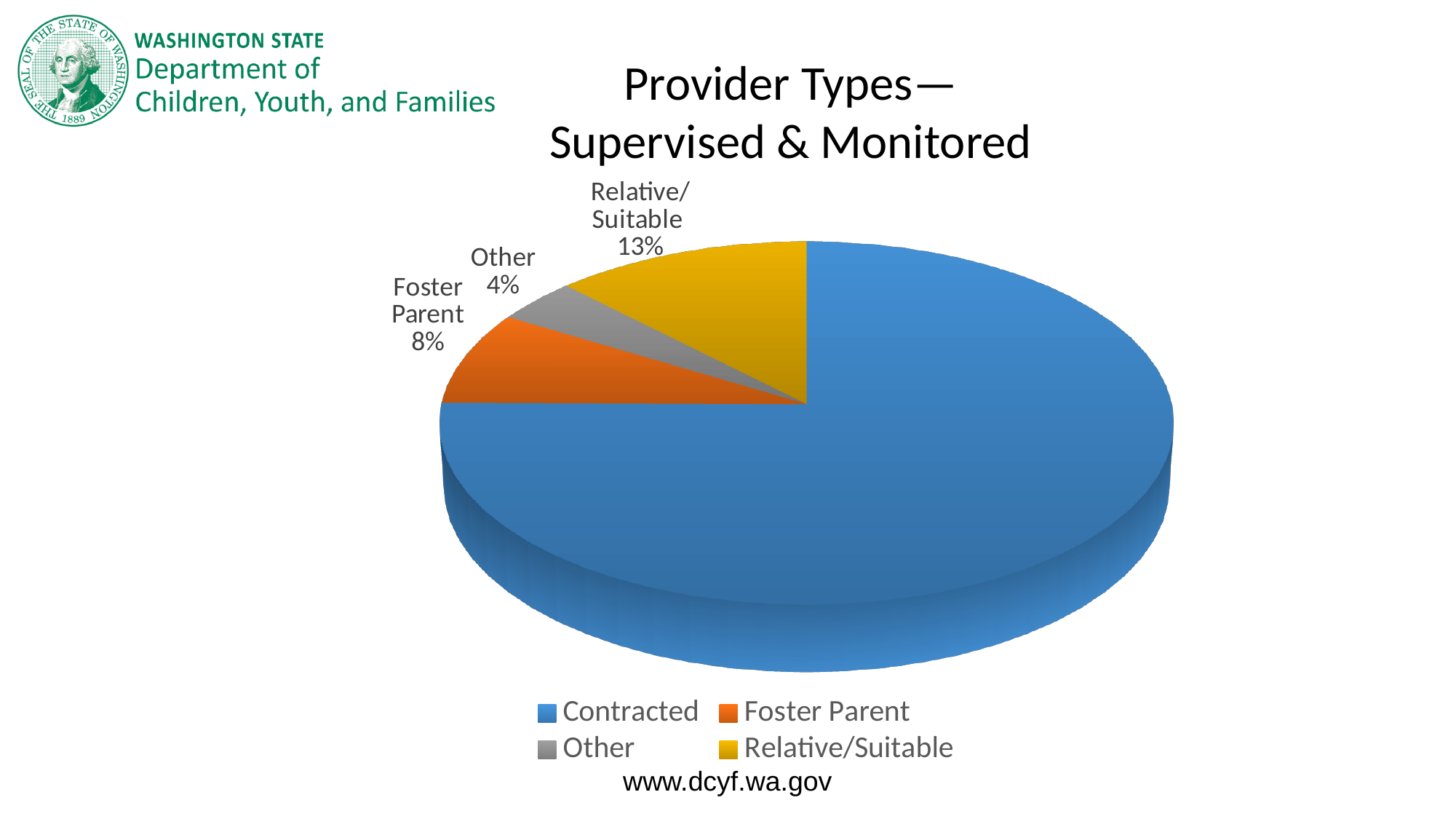
What percentage is shown for Relative/Suitable? 13% What kind of chart is shown on the slide? Pie chart What percentage is shown for the Other slice? 4% Which provider type has the smallest slice of the pie? Other Which is larger, the Other slice or the Foster Parent slice? Foster Parent Which is larger, the Relative/Suitable slice or the Foster Parent slice? Relative/Suitable What colour is the Contracted slice in the pie chart? Blue What share of the pie does Foster Parent represent? 8% How many percentage points larger is Relative/Suitable than Foster Parent? 5 Which provider type has the largest slice of the pie? Contracted How many provider types are shown in the pie chart? 4 How many percentage points larger is Foster Parent than Other? 4